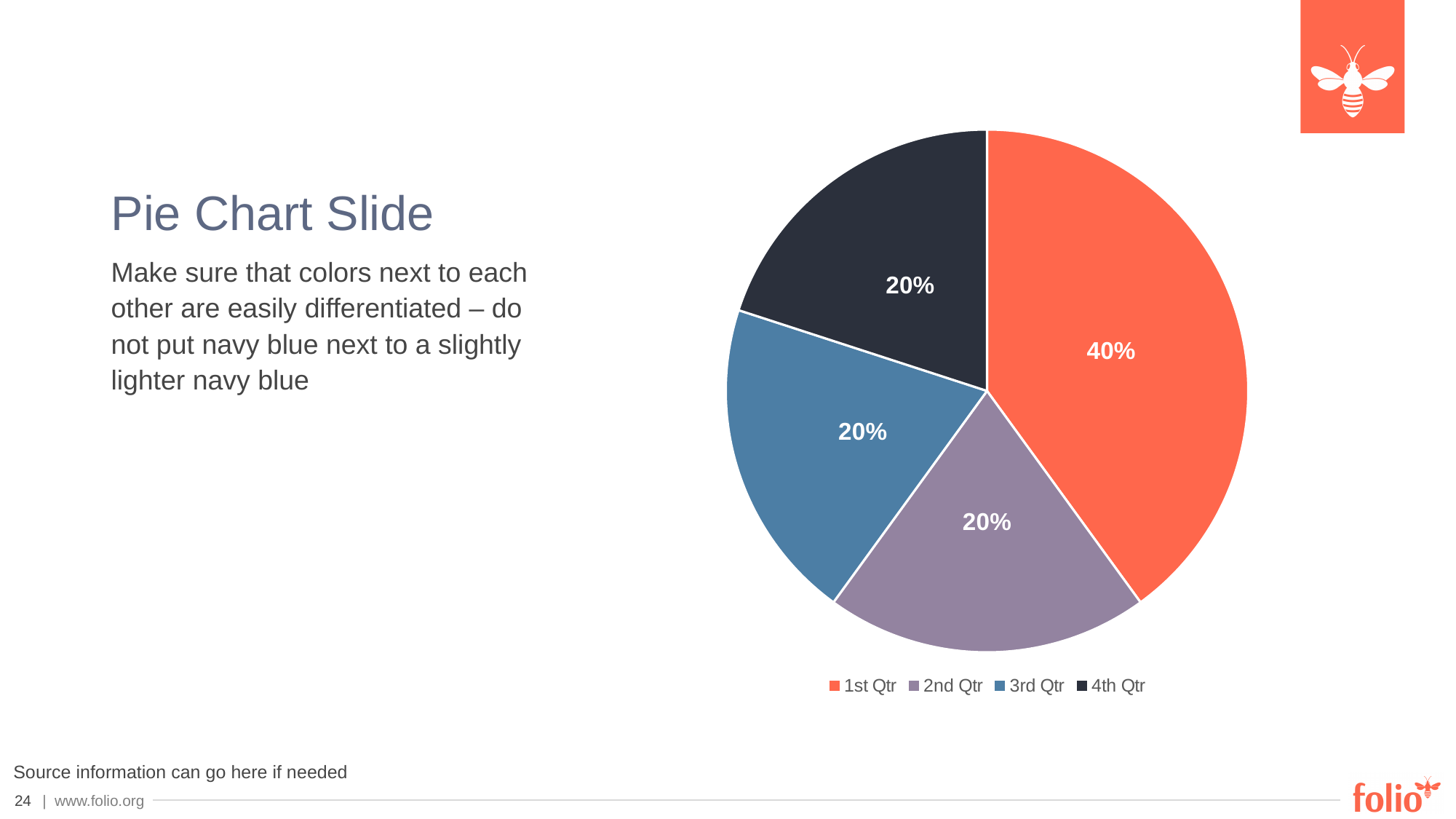
Which quarter has the largest slice of the pie? 1st Qtr How many slices does the pie chart have? 4 What share of the pie does 3rd Qtr have? 20% What share of the pie does 1st Qtr have? 40% What is the combined share of 2nd Qtr, 3rd Qtr and 4th Qtr? 60% Which is larger, the 1st Qtr slice or the 3rd Qtr slice? 1st Qtr What share of the pie does 2nd Qtr have? 20% What share of the pie does 4th Qtr have? 20% What colour is the 1st Qtr slice in the pie chart? orange What kind of chart is shown on the slide? pie chart How many entries does the legend list? 4 What is the difference between the 1st Qtr share and the 2nd Qtr share? 20%